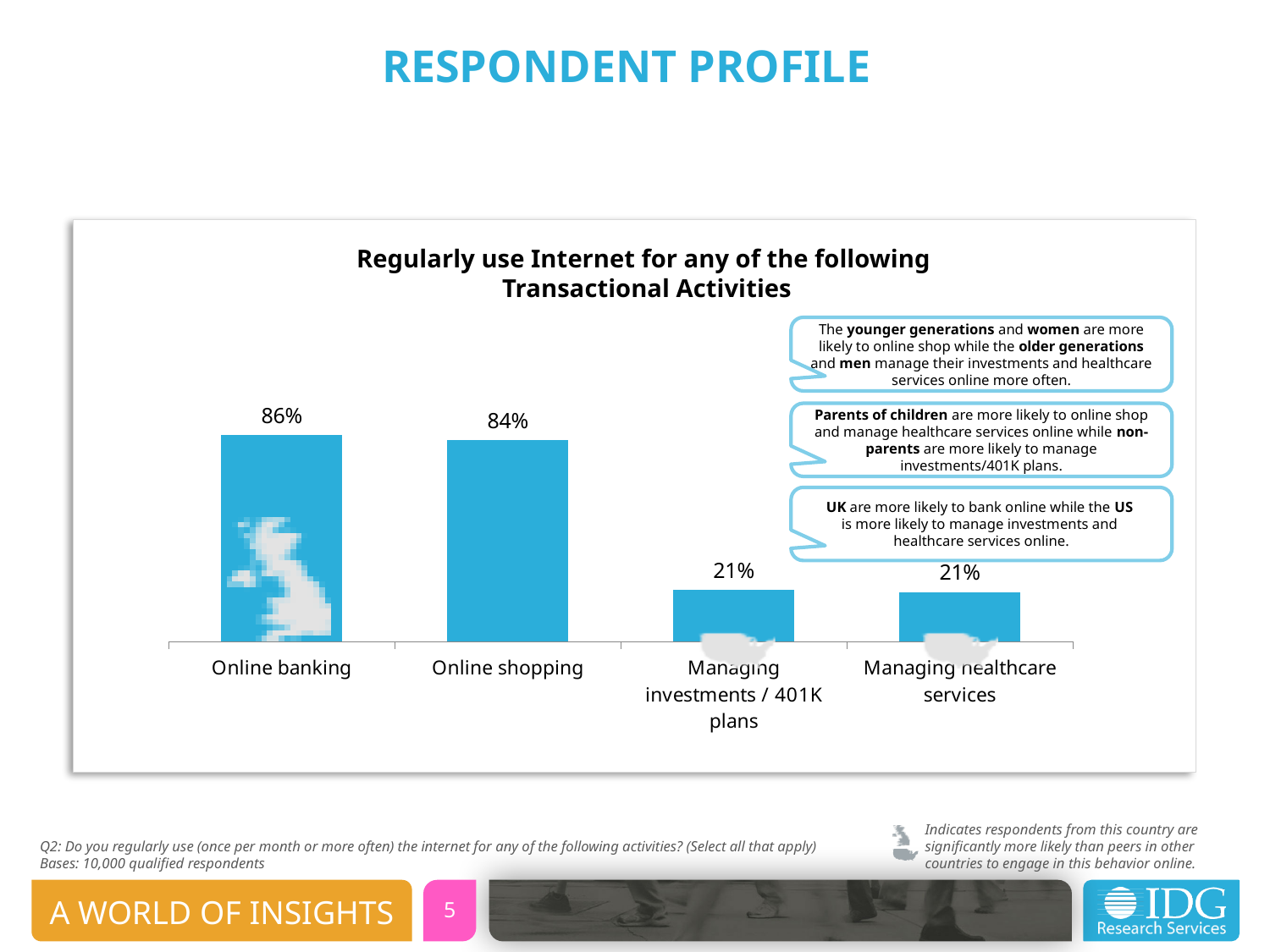
What is the title of the chart? Regularly use Internet for any of the following Transactional Activities What percentage is shown for Managing investments / 401K plans? 21% How many activity categories are shown in the chart? 4 Which activity has the highest percentage of respondents? Online banking What is the value shown for Online shopping? 84% What percentage of respondents regularly use the Internet for online banking? 86% What kind of chart is used on this slide? Bar chart What is the value for Managing healthcare services? 21% Which is larger, the value for Online banking or the value for Online shopping? Online banking What is the difference in percentage points between Online shopping and Managing investments / 401K plans? 63 percentage points What is the difference in percentage points between Online banking and Online shopping? 2 percentage points Do the values generally rise or fall from left to right across the categories? Fall